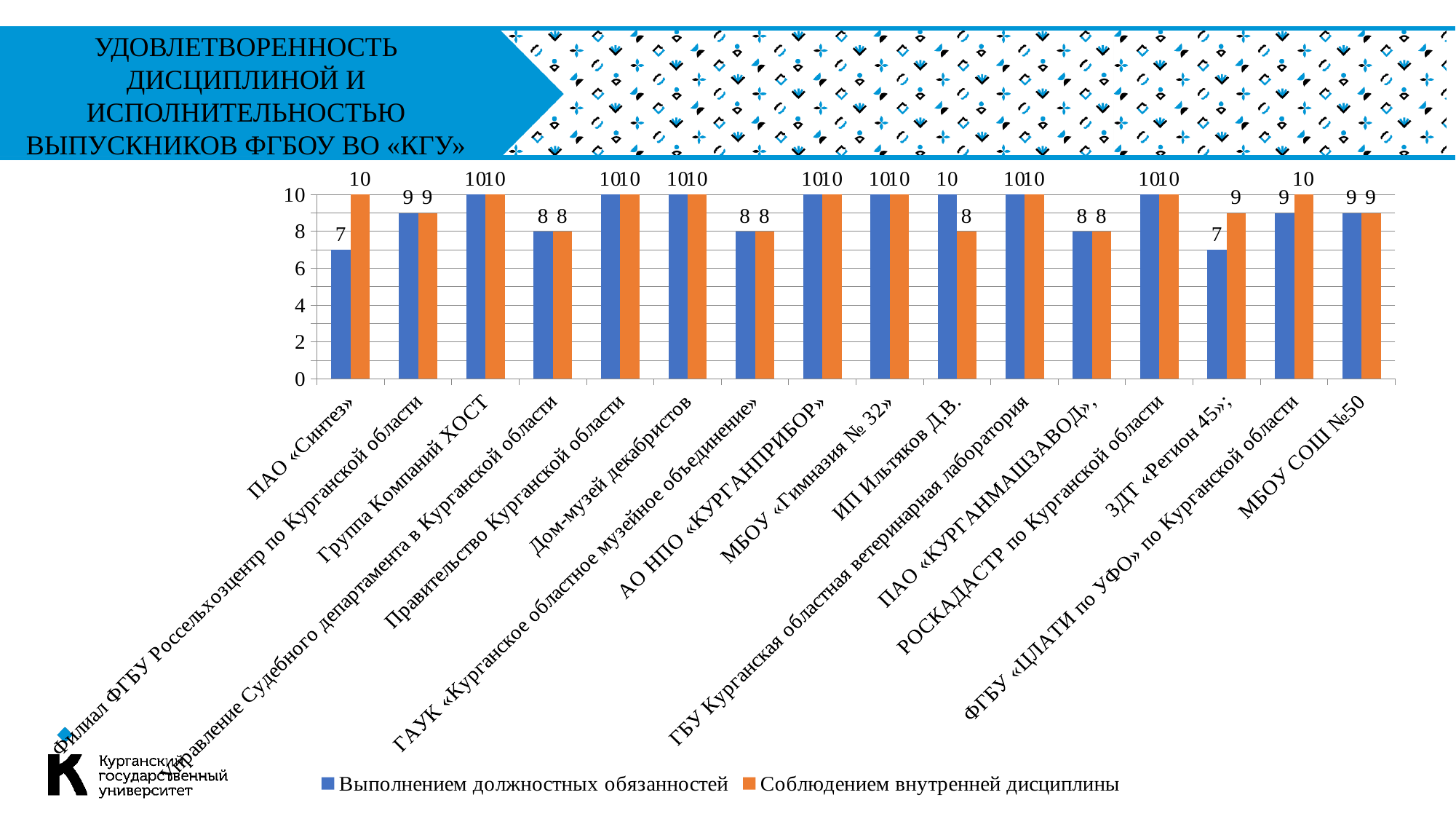
What is the difference between the two series for ПАО «Синтез»? 3 For ФГБУ «ЦЛАТИ по УФО» по Курганской области, which series has the larger value? Соблюдением внутренней дисциплины What is the value of «Выполнением должностных обязанностей» for ЗДТ «Регион 45»? 7 For ИП Ильтяков Д.В., which series has the larger value? Выполнением должностных обязанностей What is the value of «Соблюдением внутренней дисциплины» for ПАО «Синтез»? 10 What is the value of «Выполнением должностных обязанностей» for Управление Судебного департамента в Курганской области? 8 How many series does the legend list? 2 What type of chart is shown on the slide? bar chart How many organisations (categories) are shown on the x axis? 16 Which colour represents the series «Соблюдением внутренней дисциплины»? orange What is the value of «Выполнением должностных обязанностей» for ПАО «Синтез»? 7 What is the value of «Соблюдением внутренней дисциплины» for ИП Ильтяков Д.В.? 8